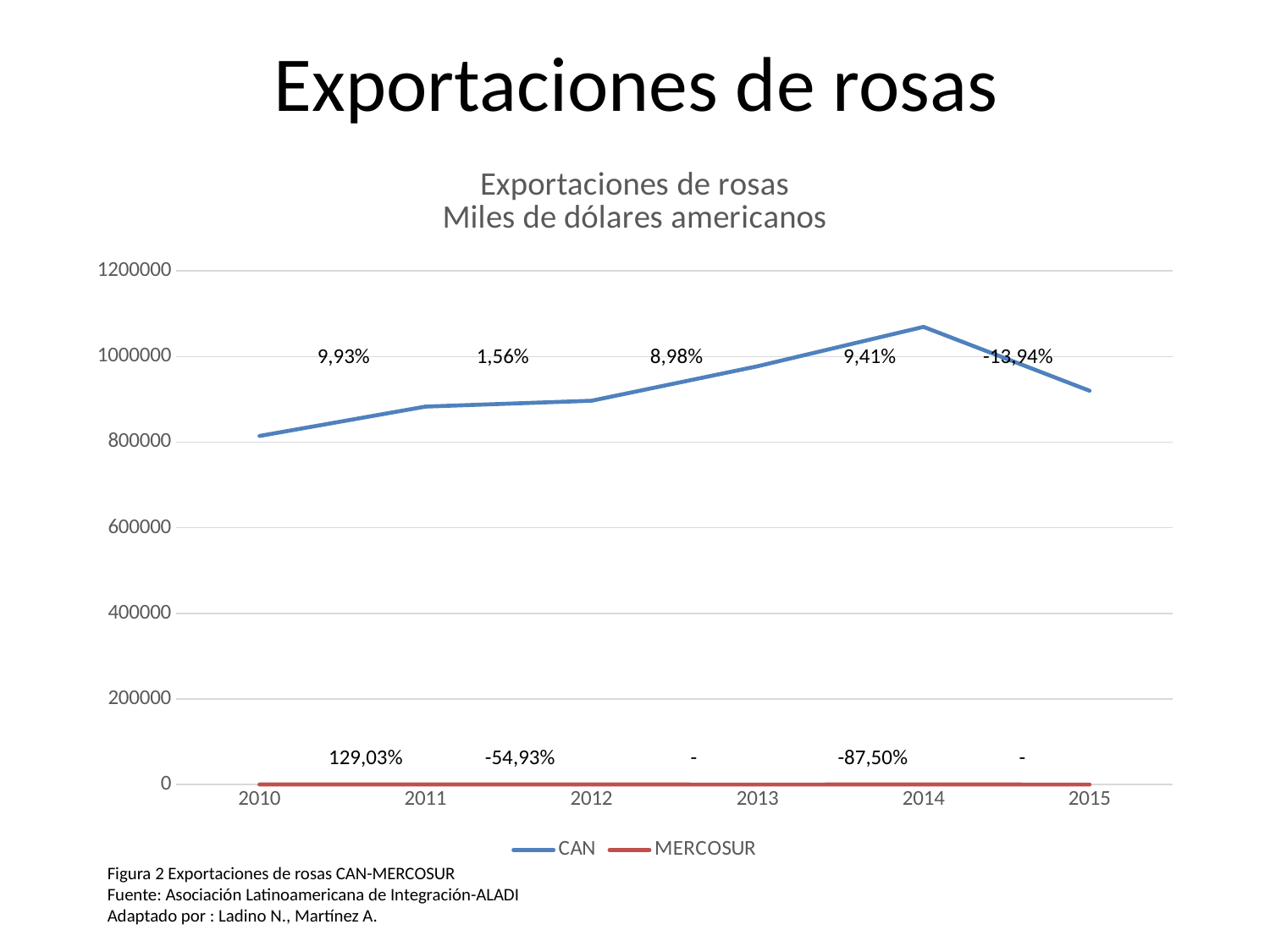
What colour is the MERCOSUR line? red What kind of chart is shown on the slide? line chart How many years are shown on the x axis? 6 Is the value for CAN in 2014 greater or less than 1000000? greater What percentage label is shown for MERCOSUR between 2010 and 2011? 129,03% In which year does the CAN line have its lowest value? 2010 Is the value for CAN in 2012 greater or less than 1000000? less What percentage label is shown on the CAN line between 2014 and 2015? -13,94% Which series has the larger value in 2013, CAN or MERCOSUR? CAN Does the CAN line rise or fall from 2010 to 2014? rise In which year does the CAN line reach its highest value? 2014 How many series does the legend list? 2